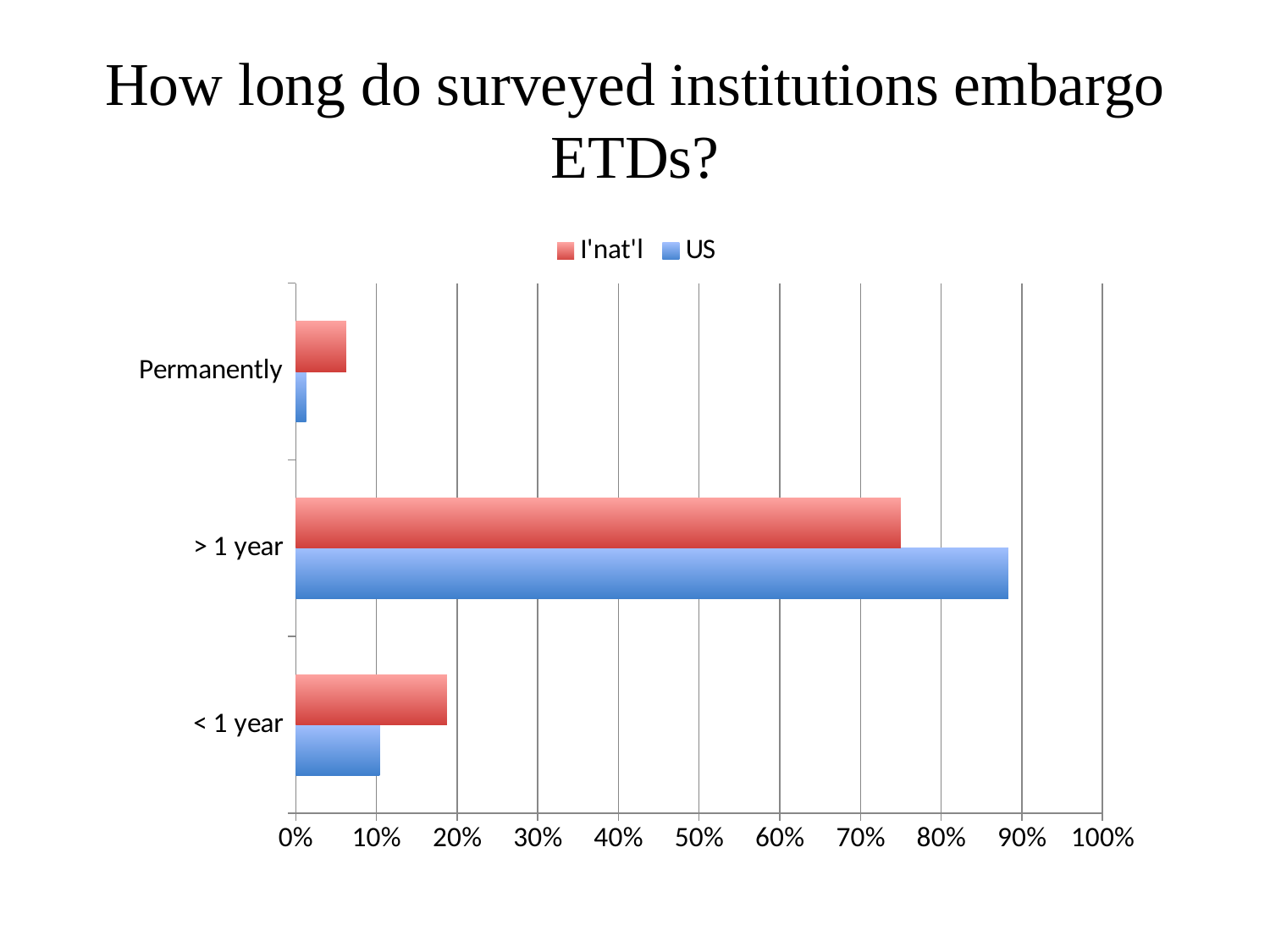
For the > 1 year category, which series has the larger value, I'nat'l or US? US Which category has the highest value for the I'nat'l series? > 1 year How many categories are shown on the chart? 3 What are the two series named in the legend? I'nat'l and US For the < 1 year category, which series has the larger value, I'nat'l or US? I'nat'l Which category has the lowest value for the US series? Permanently What kind of chart is shown on the slide? bar chart Is the I'nat'l value for > 1 year greater or less than 80%? less Is the US value for > 1 year greater or less than 80%? greater How many series does the legend list? 2 For the Permanently category, which series has the larger value, I'nat'l or US? I'nat'l Which category has the highest value for the US series? > 1 year